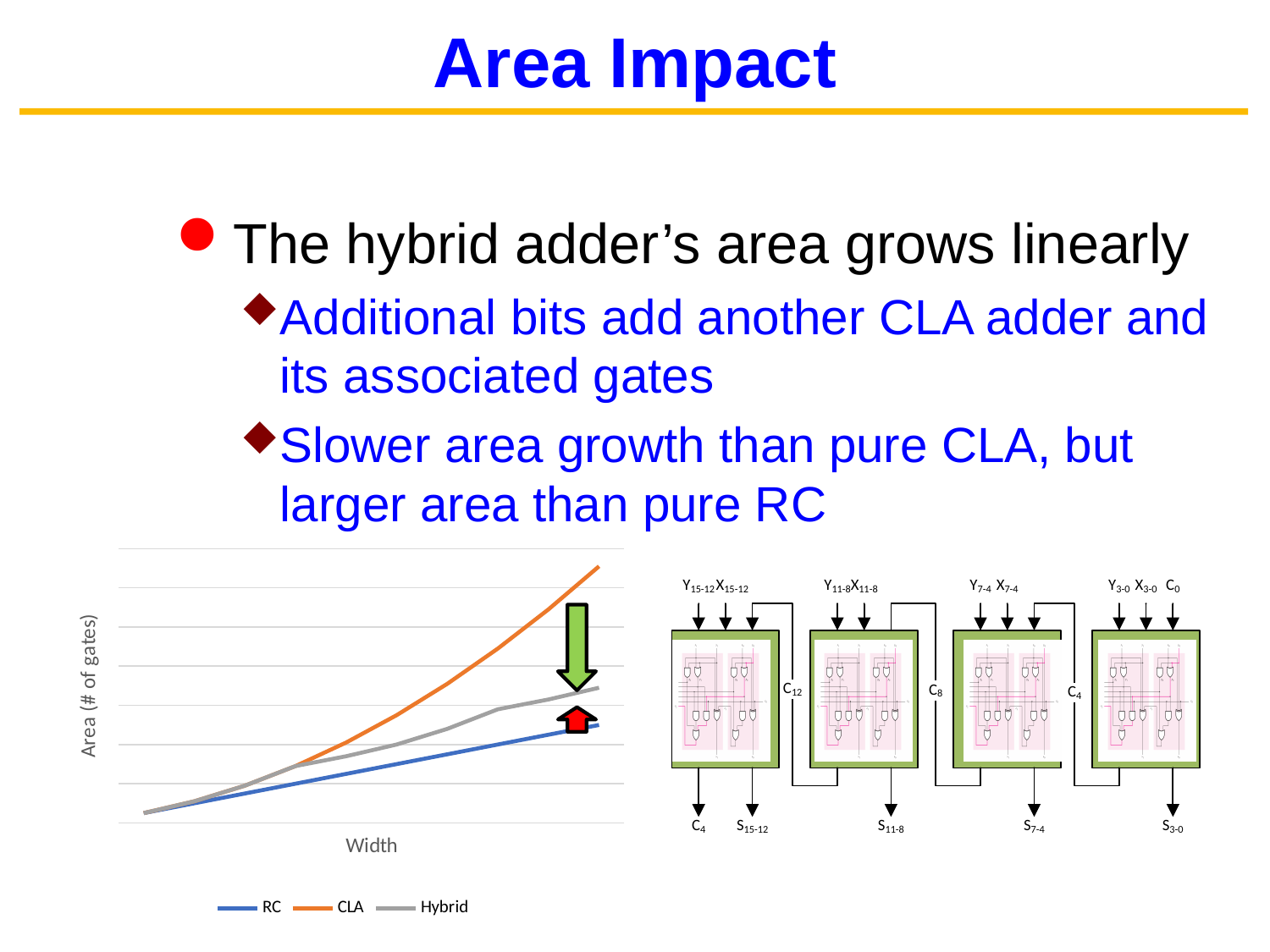
Which series reaches the highest area at the largest width on the chart? CLA At the largest width, is the area for Hybrid larger or smaller than the area for RC? larger What is the label of the chart's y axis? Area (# of gates) Which series is drawn in orange on the chart? CLA Does the area for the CLA series rise or fall as width increases? rise What kind of chart is shown on the slide? line chart Which series has the lowest area at the largest width on the chart? RC What are the series names listed in the chart's legend? RC, CLA, Hybrid At the largest width, is the area for CLA larger or smaller than the area for Hybrid? larger How many series does the chart's legend list? 3 Does the area for the RC series rise or fall as width increases? rise